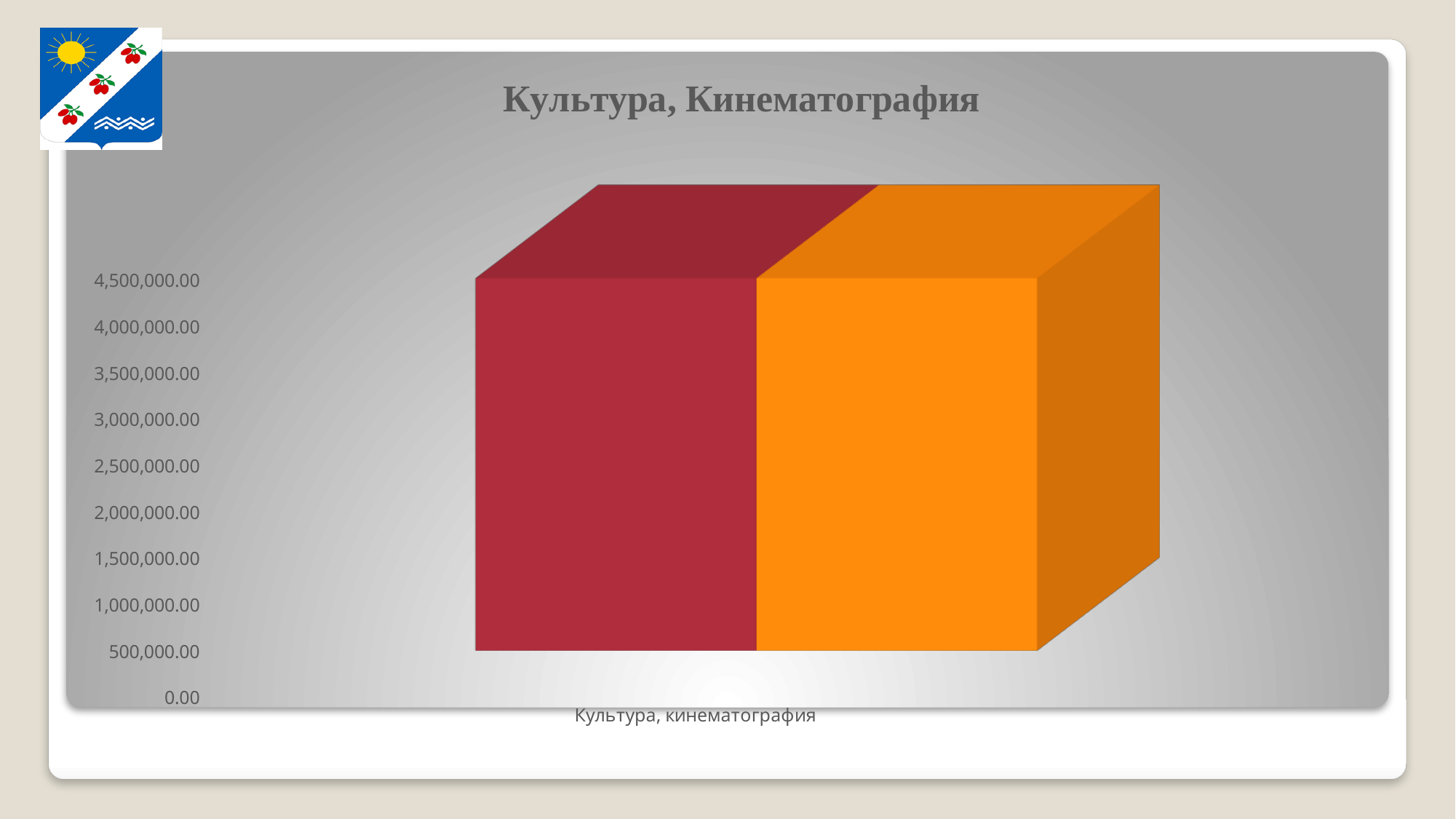
What kind of chart is shown on the slide? Bar chart How many categories are shown on the x axis of the chart? 1 What is the label of the category on the x axis? Культура, кинематография What is the title of the chart? Культура, Кинематография Is the value of the orange bar greater or less than 3,000,000.00? greater What is the lowest tick value shown on the vertical axis? 0.00 What two colours are used for the bars in the chart? Red and orange What is the highest tick value shown on the vertical axis? 4,500,000.00 How many bars are plotted in the chart? 2